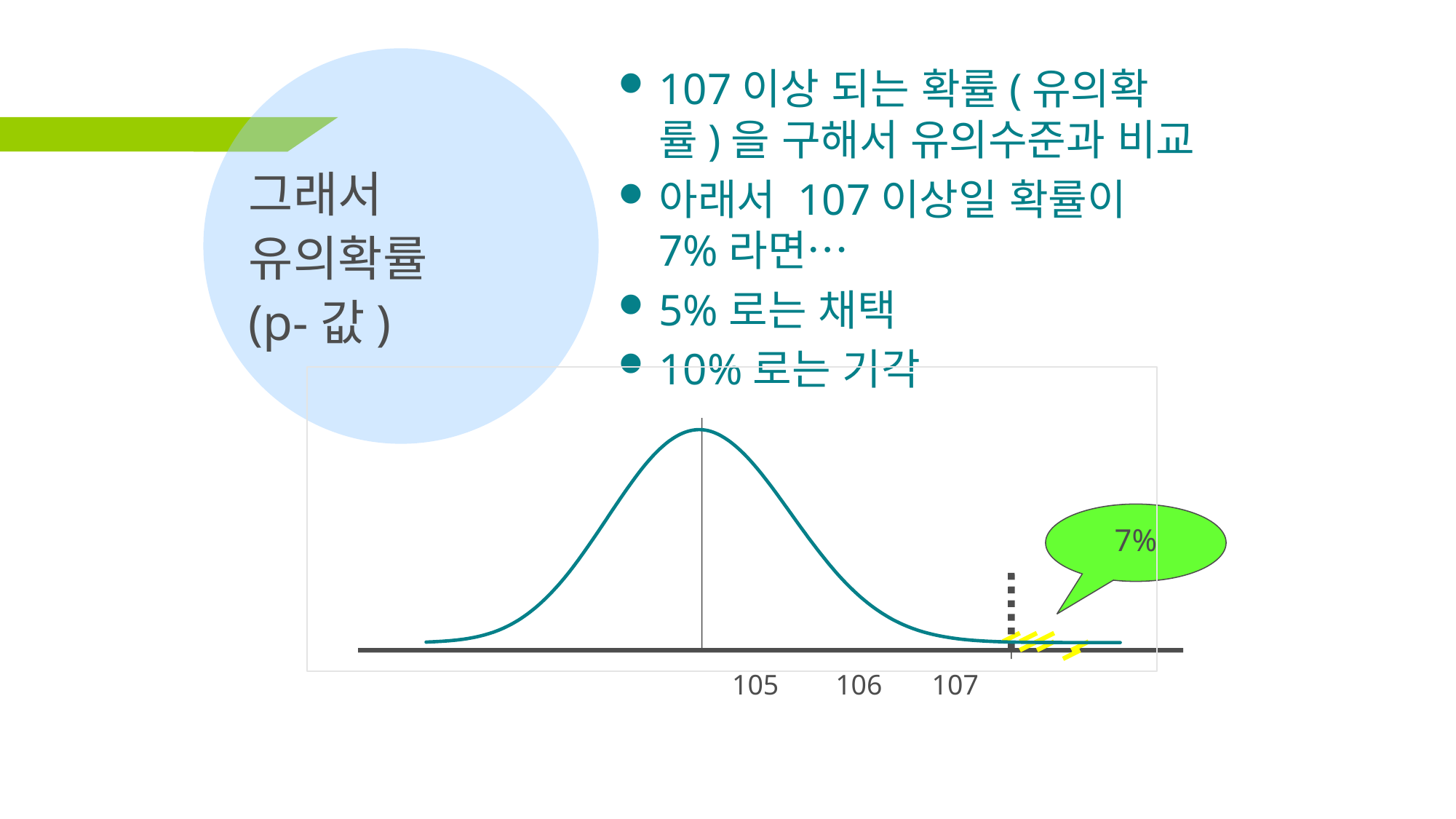
How many tick labels are printed on the x axis of the chart? 3 What are the tick labels printed on the x axis of the chart? 105, 106, 107 What kind of chart is shown on the slide? line chart Does the curve rise or fall as the x axis moves from 105 to 107? fall What value is shown in the green callout on the chart? 7% How many curves are plotted on the chart? 1 Is the dotted vertical line on the chart to the left or to the right of the 107 tick? right Which is the smallest tick label on the x axis of the chart? 105 Which is the largest tick label on the x axis of the chart? 107 Is the height of the curve at 107 larger or smaller than its height at 105? smaller